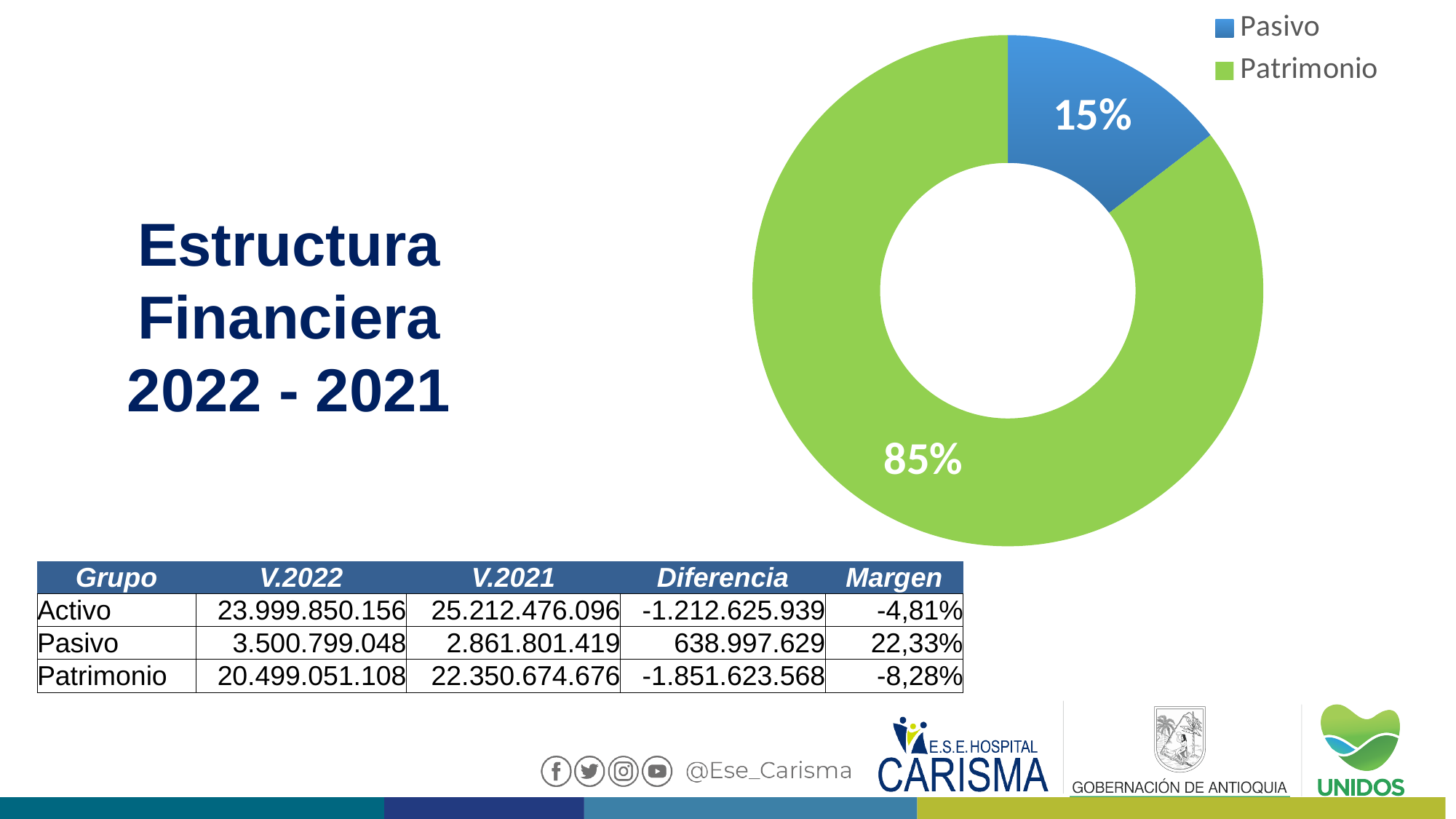
What share of the doughnut chart does Patrimonio represent? 85% What percentage does the Patrimonio slice show in the doughnut chart? 85% How many entries does the chart legend list? 2 How many slices does the doughnut chart have? 2 Which is larger in the doughnut chart, Pasivo or Patrimonio? Patrimonio What colour is the Pasivo slice in the doughnut chart? Blue What are the two entries listed in the chart legend? Pasivo and Patrimonio What percentage does the Pasivo slice show in the doughnut chart? 15% Which category has the smallest slice in the doughnut chart? Pasivo Which category has the largest slice in the doughnut chart? Patrimonio By how many percentage points does the Patrimonio slice exceed the Pasivo slice? 70 percentage points What kind of chart is shown on the slide? Doughnut (pie) chart